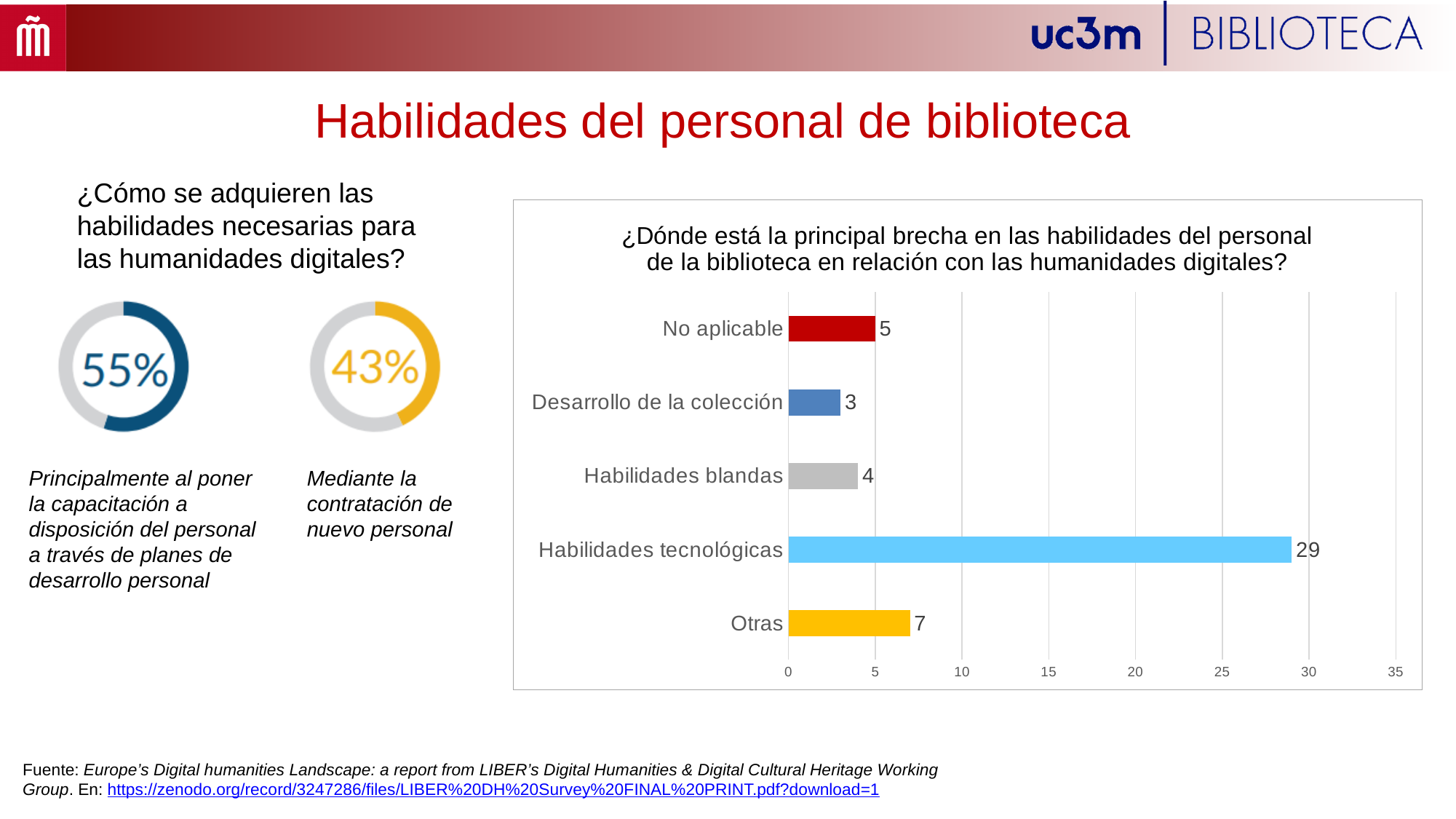
What is the maximum value shown on the x axis of the bar chart? 35 In the bar chart, what is the value for Otras? 7 In the bar chart, which is larger, the value for Habilidades blandas or the value for No aplicable? No aplicable In the bar chart, which category has the lowest value? Desarrollo de la colección In the bar chart, which category has the highest value? Habilidades tecnológicas In the bar chart, is the value for Habilidades tecnológicas greater or less than 25? greater In the bar chart, what is the value for Desarrollo de la colección? 3 How many categories does the bar chart show? 5 In the bar chart, what is the difference between the values for Habilidades tecnológicas and Otras? 22 What kind of chart is shown on the right side of the slide? bar chart In the bar chart, what is the value for Habilidades tecnológicas? 29 In the bar chart, what is the value for No aplicable? 5